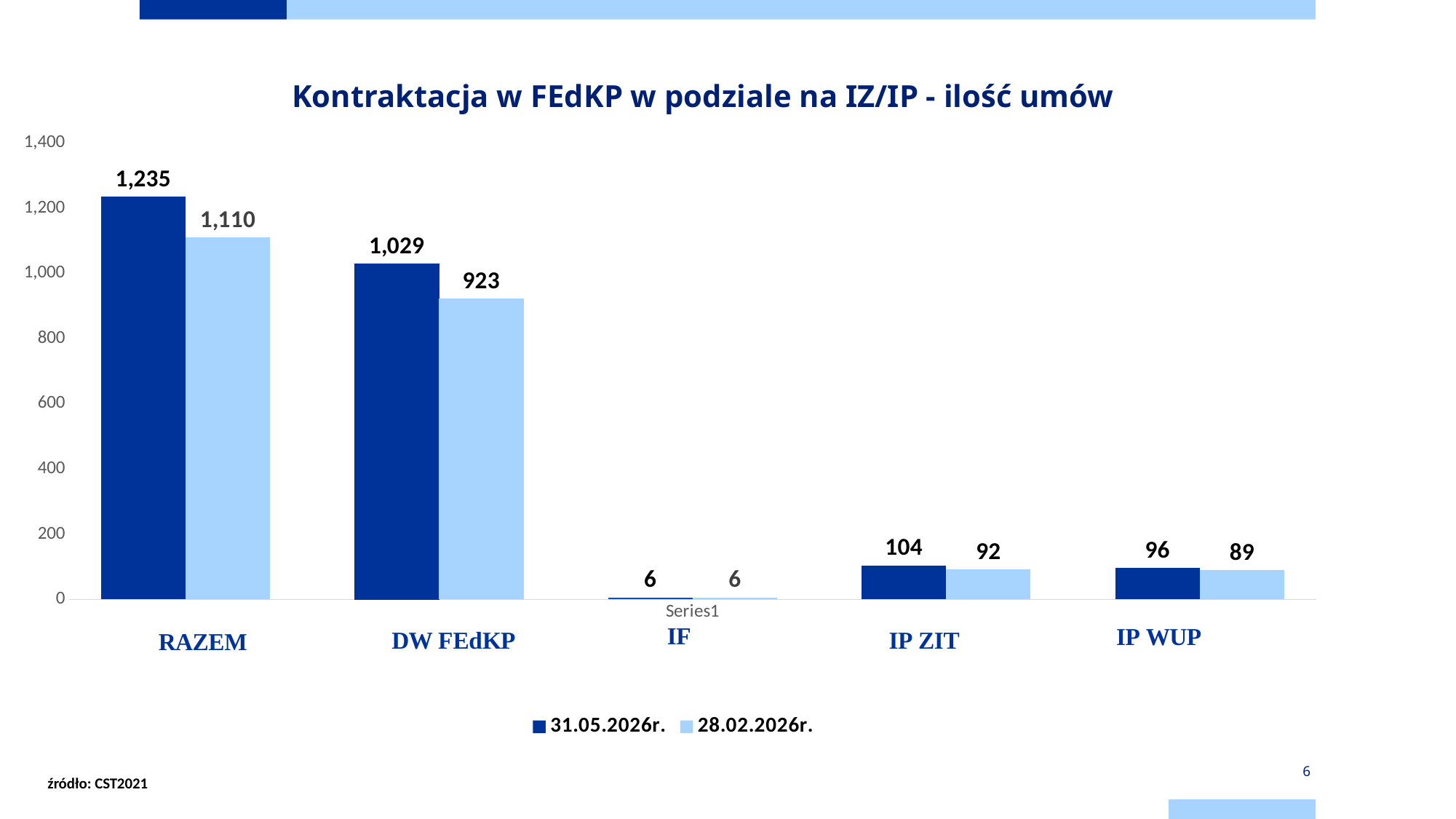
What is the value for IP ZIT in the 31.05.2026r. series? 104 How many categories are shown on the x axis? 5 What is the difference between the 31.05.2026r. and 28.02.2026r. values for DW FEdKP? 106 What is the value for DW FEdKP in the 28.02.2026r. series? 923 Which category has the highest value in the 31.05.2026r. series? RAZEM What kind of chart is shown on the slide? bar chart How many series does the legend list? 2 Which is larger: the 31.05.2026r. value for IP ZIT or the 31.05.2026r. value for IP WUP? IP ZIT What is the value for IP WUP in the 28.02.2026r. series? 89 Which category has the lowest value in the 28.02.2026r. series? IF What is the value for RAZEM in the 31.05.2026r. series? 1,235 What is the difference between the 31.05.2026r. and 28.02.2026r. values for RAZEM? 125